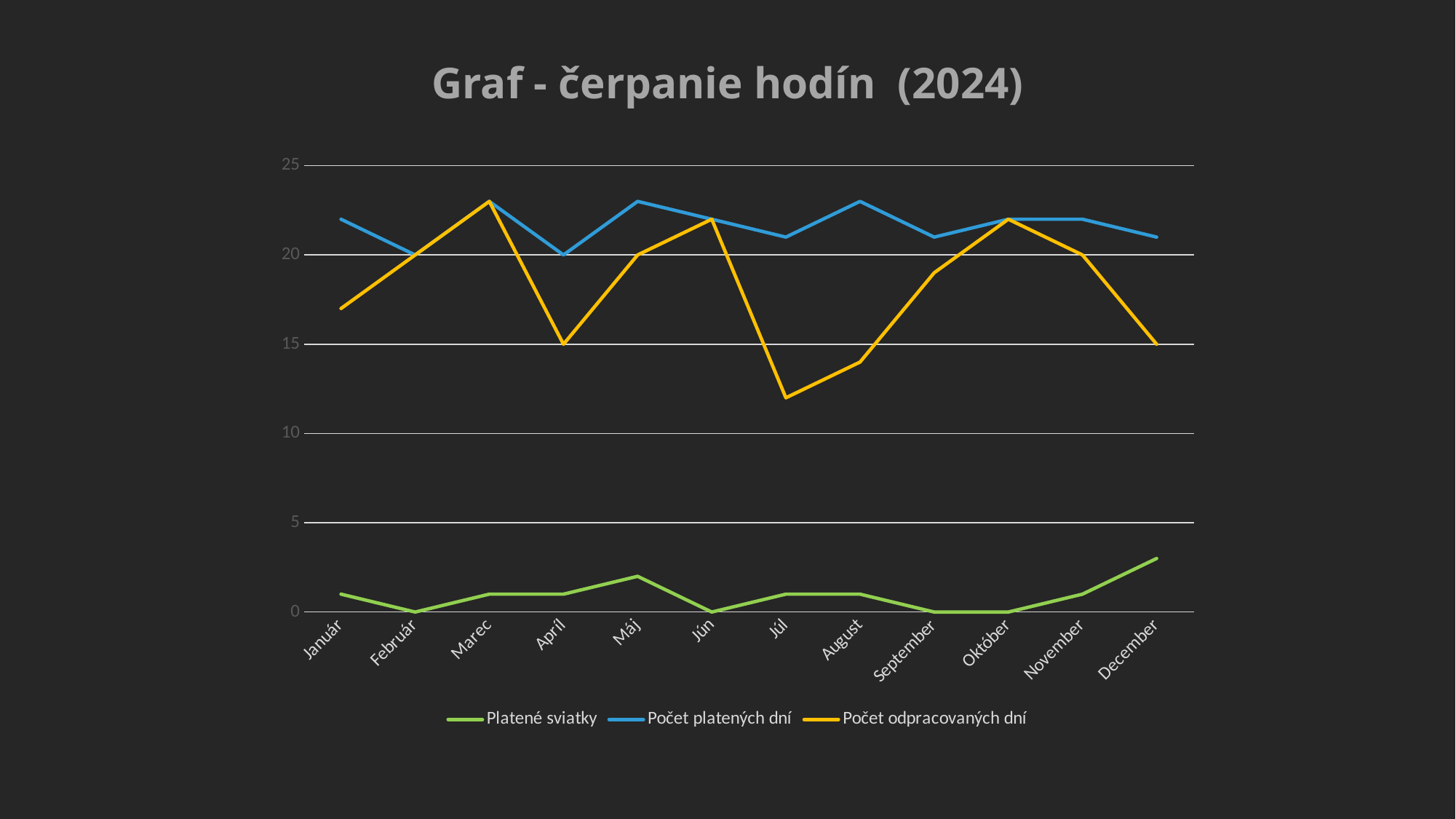
Which is larger in Jún: Počet platených dní or Platené sviatky? Počet platených dní In which month is Platené sviatky highest? December How many series does the legend list? 3 Does Počet odpracovaných dní rise or fall from November to December? fall Is the value for Počet odpracovaných dní in Júl greater or less than 15? less What is the title of the chart? Graf - čerpanie hodín (2024) In which month is Počet odpracovaných dní lowest? Júl What is the value of Platené sviatky in Február? 0 How many months are shown on the x axis? 12 What is the value of Počet platených dní in Apríl? 20 What kind of chart is shown on the slide? line chart What is the value of Počet odpracovaných dní in Apríl? 15